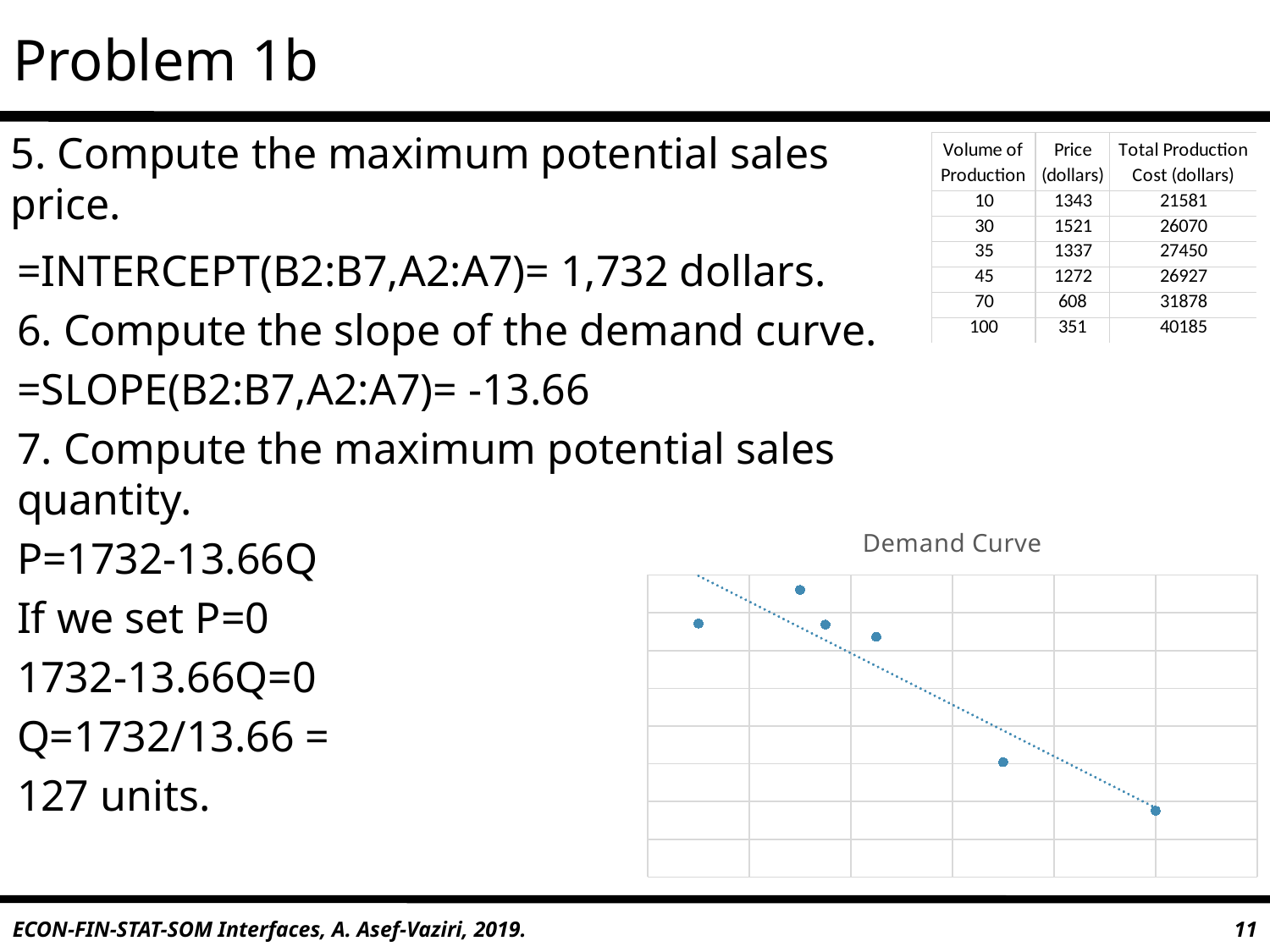
What is the title of the chart on the slide? Demand Curve On the "Demand Curve" chart, is the rightmost point higher or lower than the leftmost point? lower Do the plotted values on the "Demand Curve" chart generally rise or fall from left to right? fall Does the "Demand Curve" chart include a trendline through the points? yes, a dotted trendline What kind of chart is the "Demand Curve" chart? scatter chart How many data points are plotted on the "Demand Curve" chart? 6